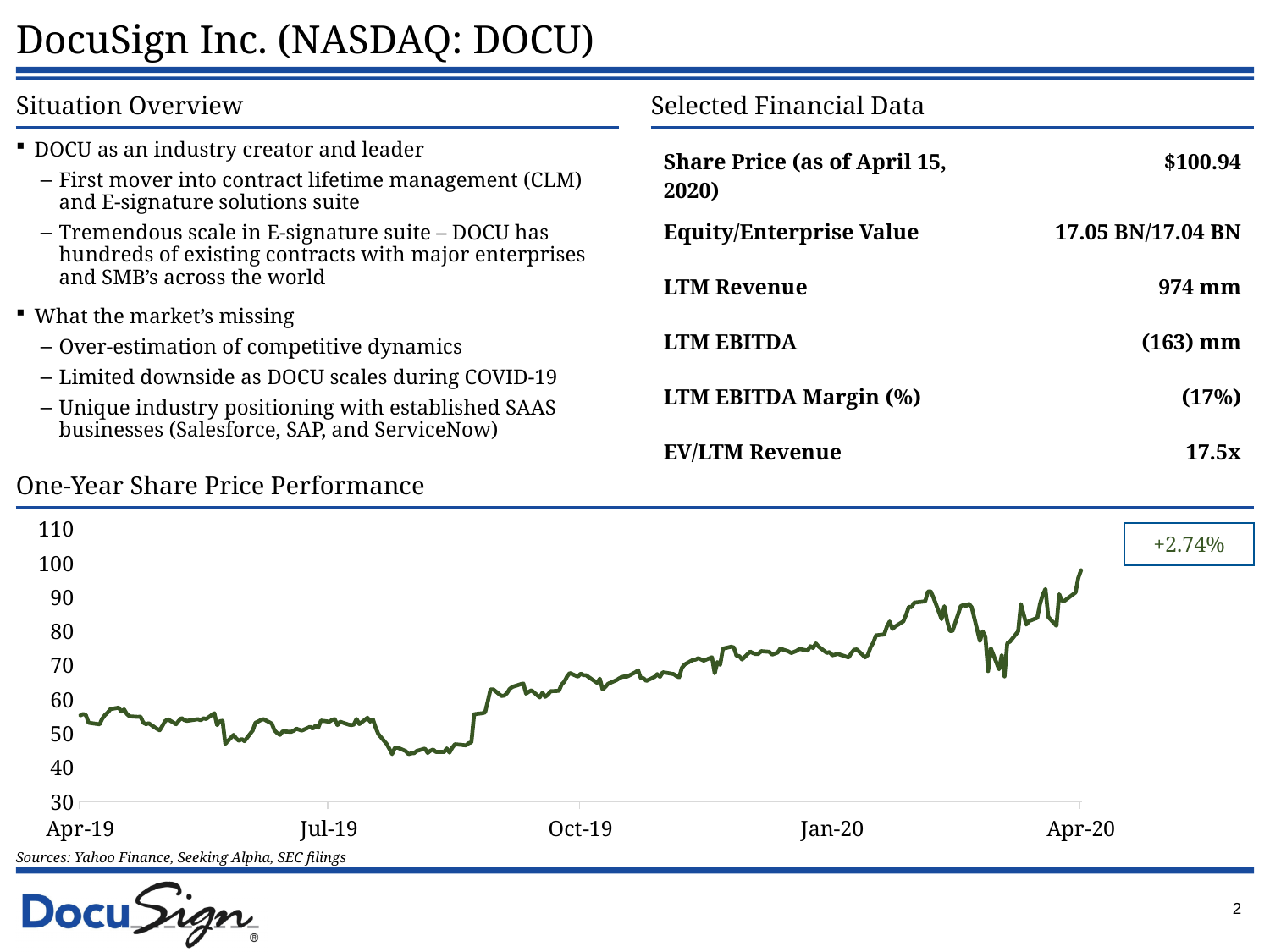
In the One-Year Share Price Performance chart, is the share price at Jul-19 greater or less than 60? less In the One-Year Share Price Performance chart, is the share price at Oct-19 greater or less than 60? greater Is the share price at Apr-20 higher or lower than at Apr-19 in the One-Year Share Price Performance chart? higher Among the labeled dates on the x axis of the One-Year Share Price Performance chart, which has the highest share price? Apr-20 What percentage is shown in the box at the top right of the One-Year Share Price Performance chart? +2.74% Overall, does the share price rise or fall from Apr-19 to Apr-20 in the One-Year Share Price Performance chart? rise How many date labels are shown on the x axis of the One-Year Share Price Performance chart? 5 What kind of chart is shown under "One-Year Share Price Performance"? line chart In the One-Year Share Price Performance chart, is the share price at Jan-20 greater or less than 70? greater